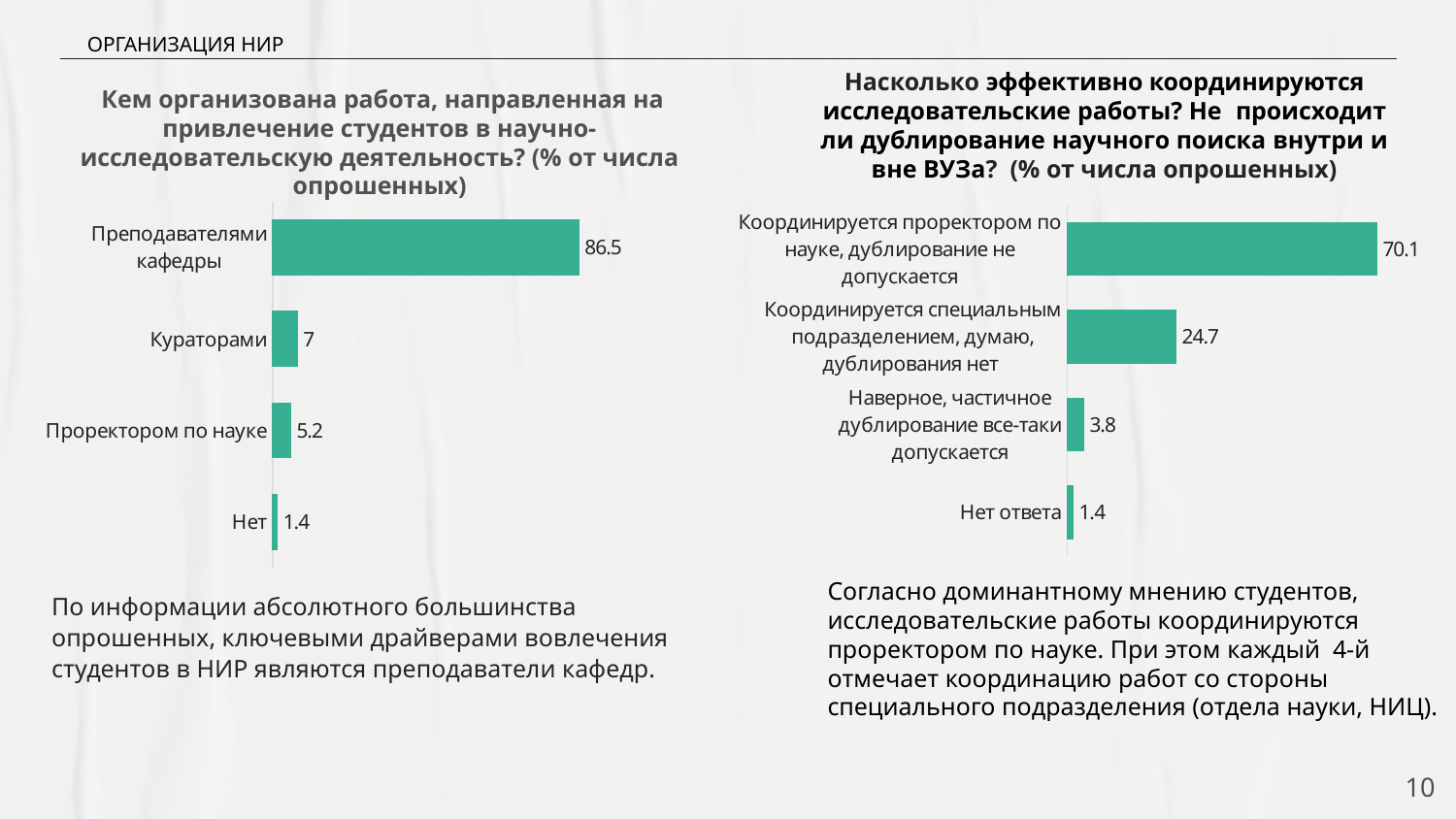
In the right chart, what is the difference between the values for 'Координируется специальным подразделением, думаю, дублирования нет' and 'Нет ответа'? 23.3 In the right chart, what is the value for 'Координируется проректором по науке, дублирование не допускается'? 70.1 In the left chart, which category has the lowest value? Нет In the left chart, what is the difference between the values for 'Преподавателями кафедры' and 'Кураторами'? 79.5 How many categories are shown in the right chart? 4 In the right chart, which category has the highest value? Координируется проректором по науке, дублирование не допускается In the left chart, what is the value for 'Кураторами'? 7 What type of chart is the left chart? Bar chart In the left chart, which is larger: the value for 'Кураторами' or for 'Проректором по науке'? Кураторами In the left chart, what is the value for 'Преподавателями кафедры'? 86.5 In the right chart, what is the value for 'Наверное, частичное дублирование все-таки допускается'? 3.8 How many categories are shown in the left chart? 4